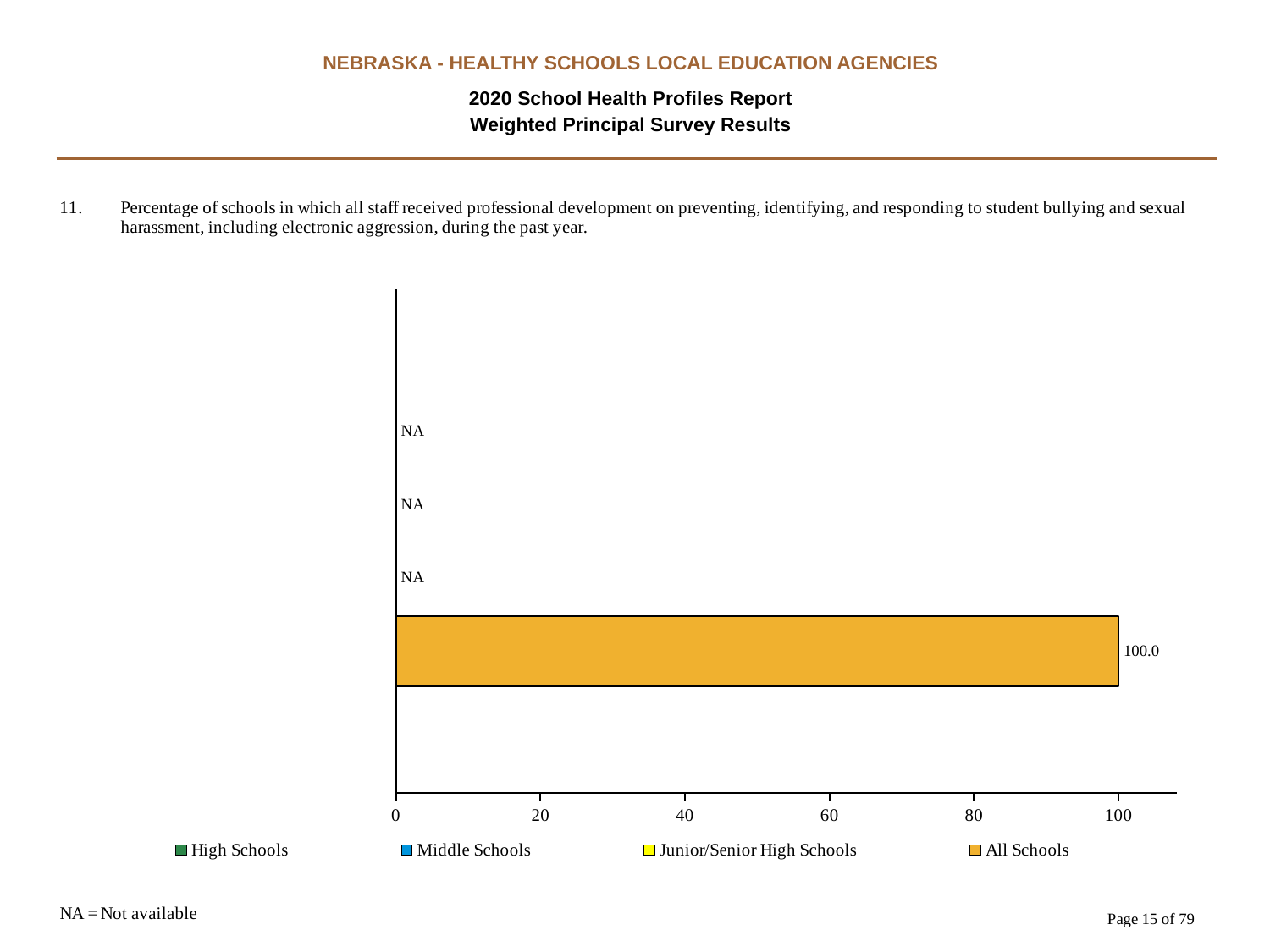
How many series are marked NA? 3 How many series does the legend list? 4 What colour is the All Schools bar? Orange/yellow Is the value for All Schools greater or less than 80? greater What is shown for Middle Schools? NA What kind of chart is shown? Bar chart What is shown for High Schools? NA What is the value for All Schools? 100.0 What is the highest value shown on the x axis? 100 What is shown for Junior/Senior High Schools? NA Which series is the only one with a plotted bar? All Schools